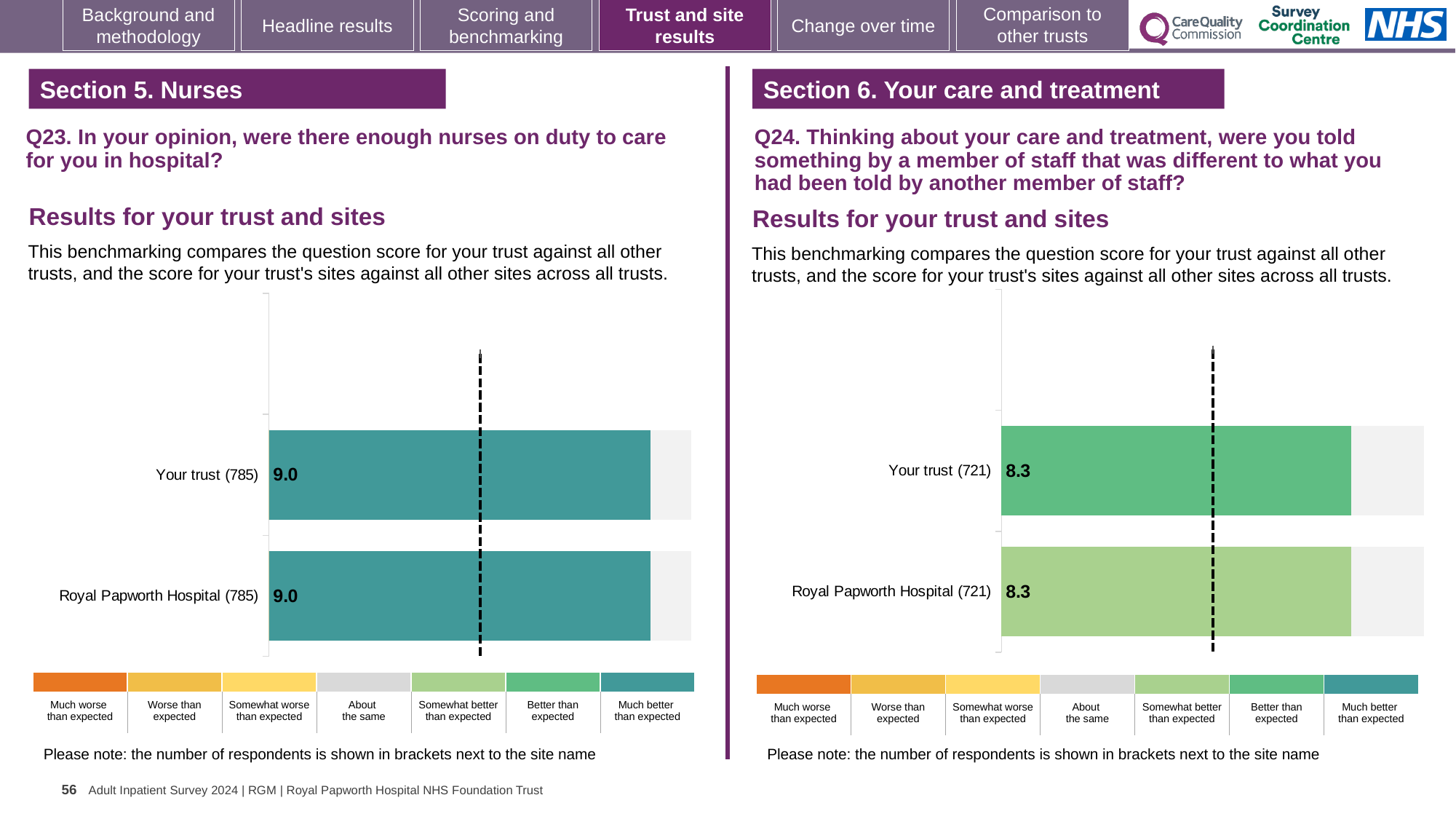
In the Q23 chart on the left, what is the score for Royal Papworth Hospital? 9.0 In the Q23 chart on the left, what is the difference between the Your trust score and the Royal Papworth Hospital score? 0.0 How many bars are plotted in the Q24 chart on the right? 2 In the Q24 chart on the right, how many respondents are shown in brackets next to Royal Papworth Hospital? 721 In the Q24 chart on the right, what is the score for Your trust? 8.3 In the Q24 chart on the right, what is the score for Royal Papworth Hospital? 8.3 How many bars are plotted in the Q23 chart on the left? 2 What kind of chart is the Q23 chart on the left? Bar chart In the Q23 chart on the left, what is the score for Your trust? 9.0 In the Q23 chart on the left, how many respondents are shown in brackets next to Your trust? 785 Is the Your trust score in the Q23 chart on the left larger or smaller than the Your trust score in the Q24 chart on the right? Larger In the Q24 chart on the right, what is the difference between the Your trust score and the Royal Papworth Hospital score? 0.0